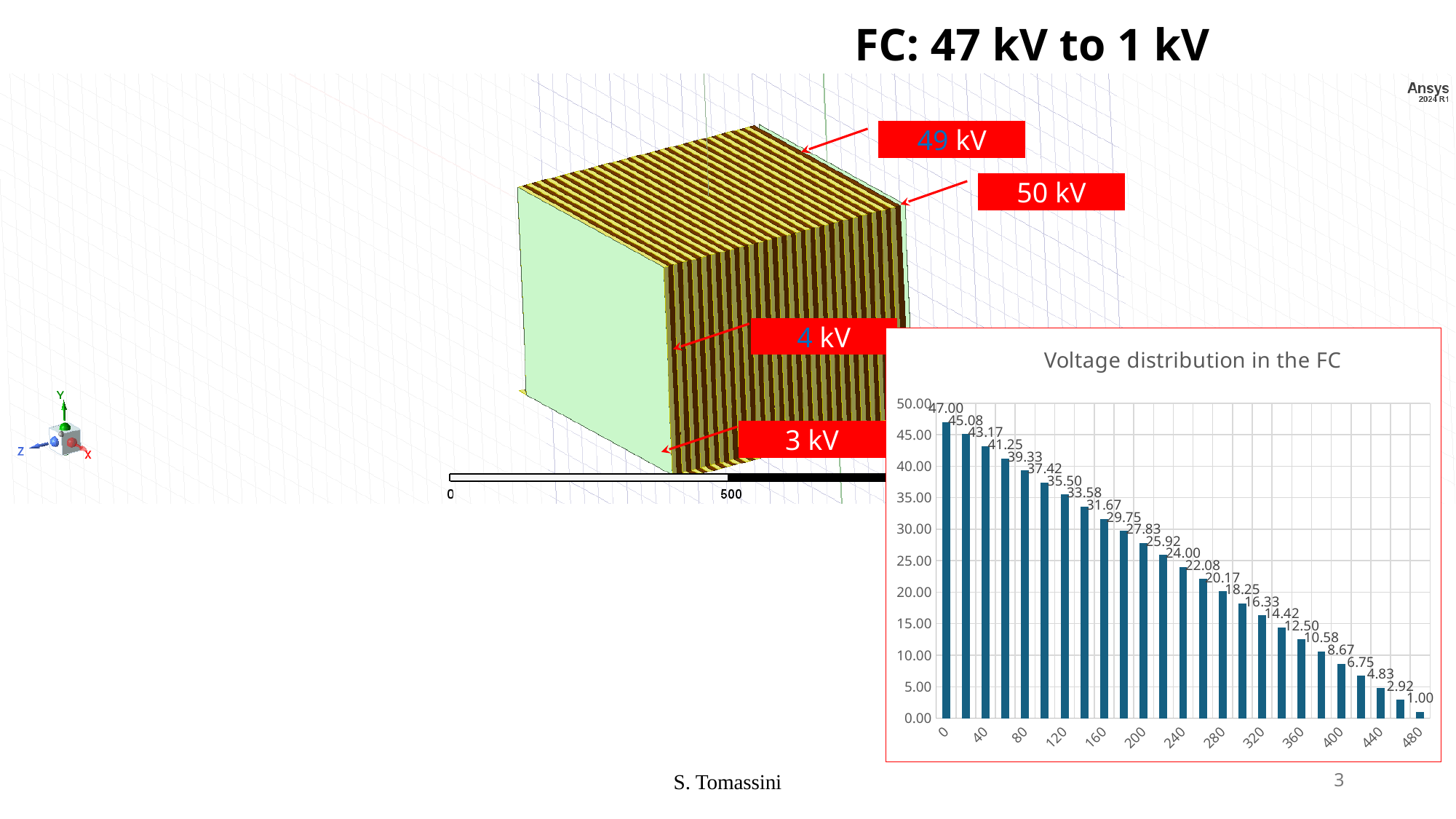
What kind of chart is 'Voltage distribution in the FC'? bar chart In the 'Voltage distribution in the FC' chart, which x position has the highest bar? 0 In the 'Voltage distribution in the FC' chart, which is larger: the bar at x = 120 or the bar at x = 320? x = 120 In the 'Voltage distribution in the FC' chart, what is the value of the bar at x = 400? 8.67 In the 'Voltage distribution in the FC' chart, what is the value of the bar at x = 0? 47.00 In the 'Voltage distribution in the FC' chart, what is the difference between the bar at x = 0 and the bar at x = 480? 46.00 What is the title of the chart on the slide? Voltage distribution in the FC In the 'Voltage distribution in the FC' chart, which x position has the lowest bar? 480 In the 'Voltage distribution in the FC' chart, do the values rise or fall as x increases? fall How many bars are plotted in the 'Voltage distribution in the FC' chart? 25 In the 'Voltage distribution in the FC' chart, what is the value of the bar at x = 240? 24.00 In the 'Voltage distribution in the FC' chart, what is the value of the bar at x = 480? 1.00